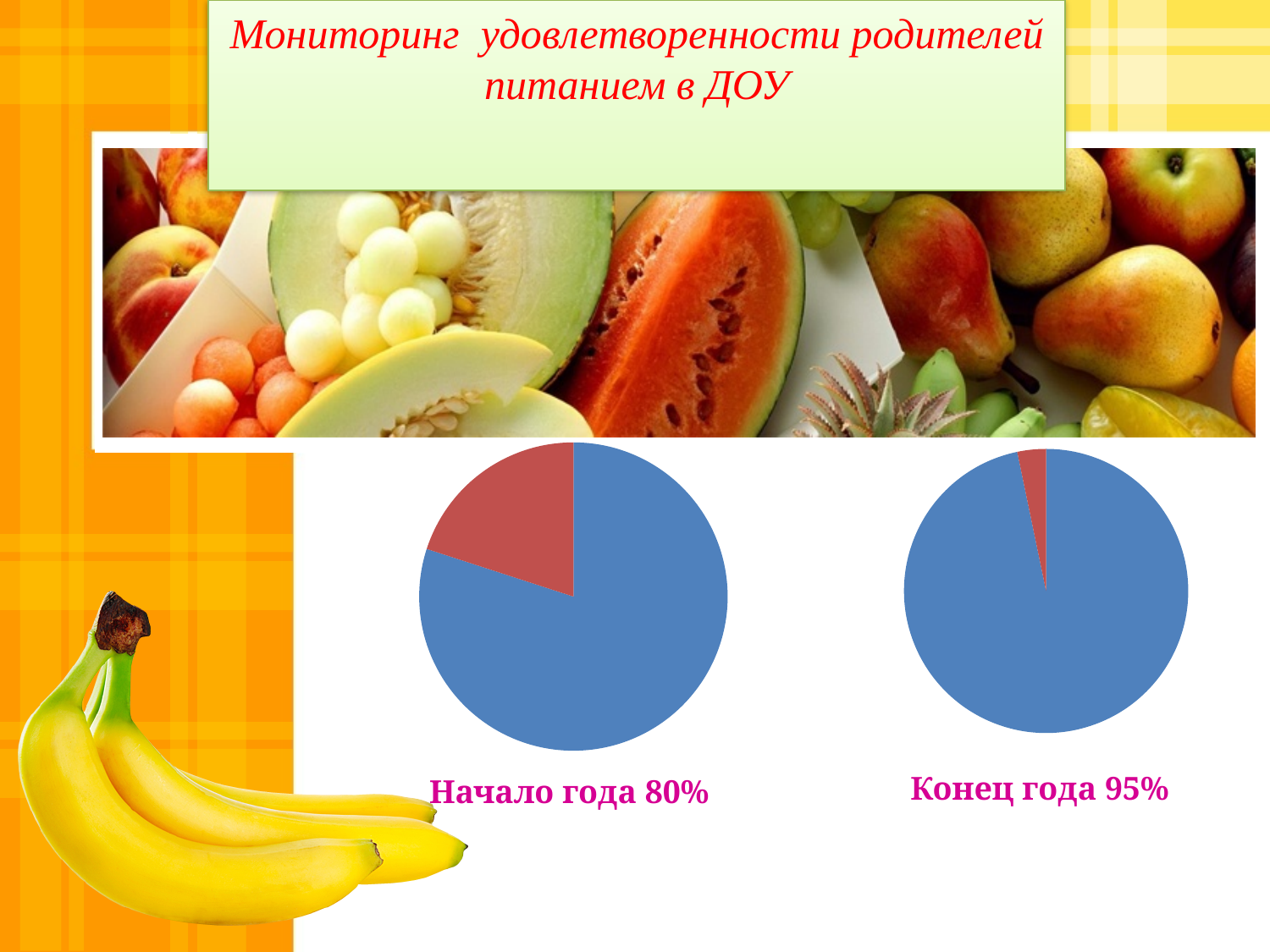
What percentage is shown for the right chart, Конец года? 95% What percentage is shown for the left chart, Начало года? 80% What kind of charts are shown on the slide? Pie charts What is the title of the slide containing the charts? Мониторинг удовлетворенности родителей питанием в ДОУ What is the difference between the Конец года value and the Начало года value? 15% How many slices does each pie chart have? 2 Which is larger, the value for Начало года or for Конец года? Конец года What colour is the larger slice in both pie charts? Blue In the left chart (Начало года), what share does the red slice represent? 20% Does the satisfaction value rise or fall from Начало года to Конец года? Rise How many charts are on the slide? 2